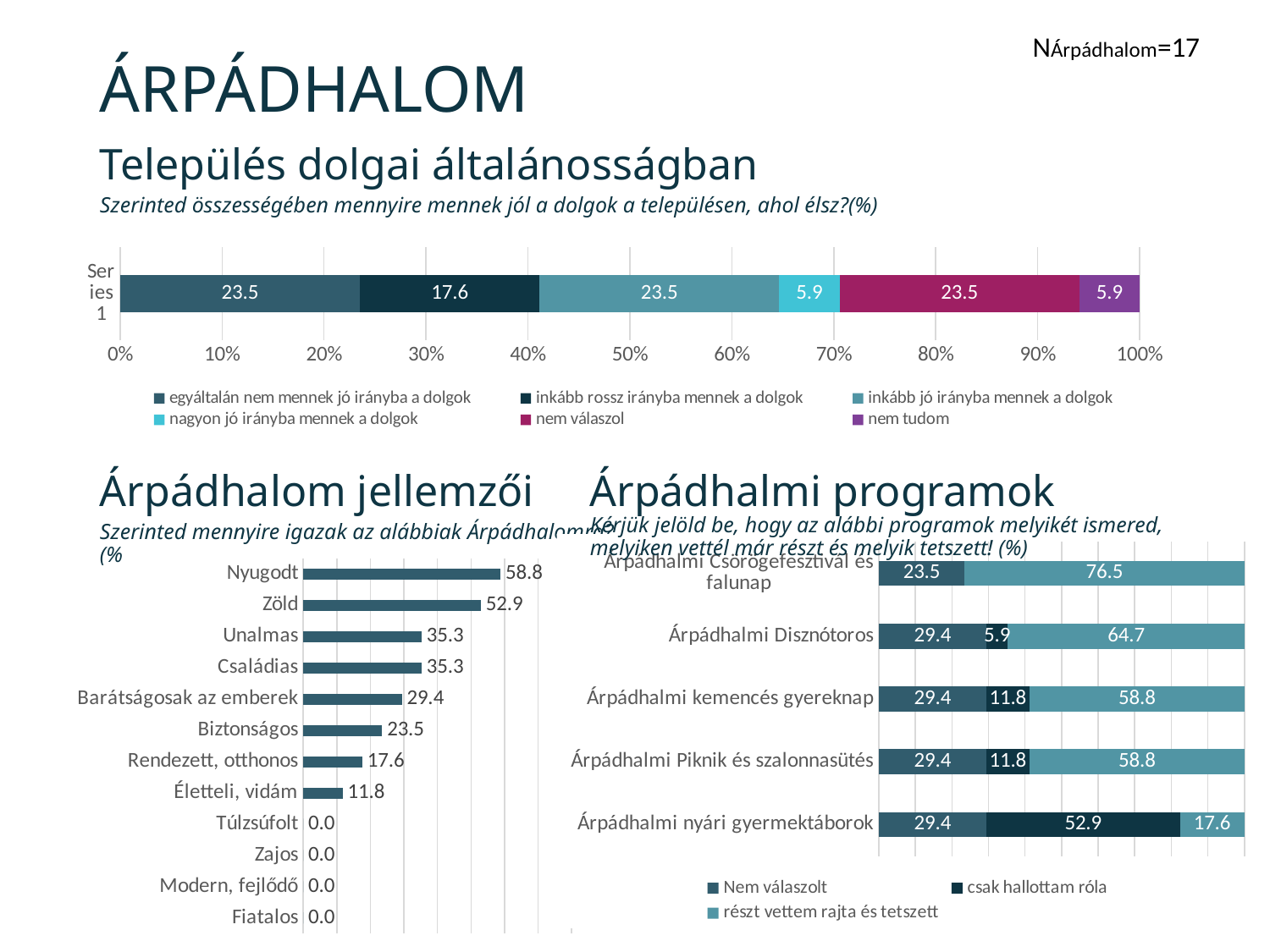
In the bottom-left chart (Árpádhalom jellemzői), which category has the highest value? Nyugodt In the bottom-right chart (Árpádhalmi programok), what is the 'részt vettem rajta és tetszett' value for 'Árpádhalmi Disznótoros'? 64.7 In the top chart (Település dolgai általánosságban), what is the value for 'inkább rossz irányba mennek a dolgok'? 17.6 In the bottom-left chart (Árpádhalom jellemzői), what is the value for 'Biztonságos'? 23.5 In the top chart (Település dolgai általánosságban), how many series does the legend list? 6 In the bottom-left chart (Árpádhalom jellemzői), what is the difference between 'Nyugodt' and 'Zöld'? 5.9 In the bottom-right chart (Árpádhalmi programok), how many programs (categories) are listed? 5 In the top chart (Település dolgai általánosságban), what is the value for 'nagyon jó irányba mennek a dolgok'? 5.9 In the bottom-left chart (Árpádhalom jellemzői), how many categories are shown? 12 In the bottom-right chart (Árpádhalmi programok), what is the 'csak hallottam róla' value for 'Árpádhalmi nyári gyermektáborok'? 52.9 In the bottom-right chart (Árpádhalmi programok), which is larger: the 'részt vettem rajta és tetszett' value for 'Árpádhalmi Csörögefesztivál és falunap' or for 'Árpádhalmi kemencés gyereknap'? Árpádhalmi Csörögefesztivál és falunap In the bottom-left chart (Árpádhalom jellemzői), what kind of chart is it? bar chart